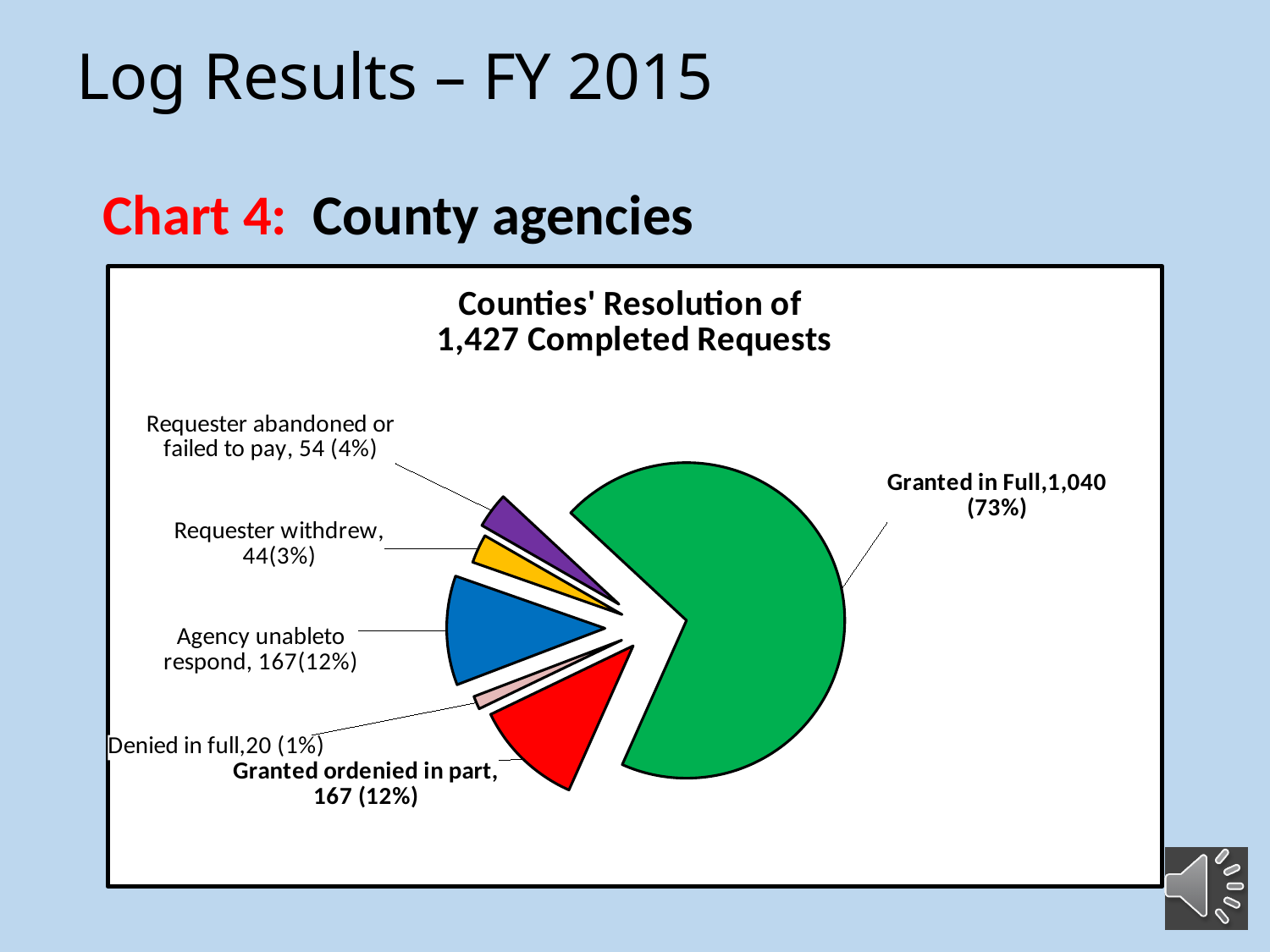
How many categories are shown in the pie chart? 6 What is the difference between the number of requests Granted in Full and the number where the Agency was unable to respond? 873 How many requests were Denied in full? 20 What is the title of the pie chart? Counties' Resolution of 1,427 Completed Requests What kind of chart is shown on the slide? pie chart How many requests fall under 'Requester abandoned or failed to pay'? 54 Which is larger: the number of requests where the Requester withdrew or the number where the Requester abandoned or failed to pay? Requester abandoned or failed to pay Which category has the largest slice of the pie? Granted in Full Which category has the smallest slice of the pie? Denied in full What percentage of completed requests were Granted in Full? 73% How many requests were Granted in Full? 1,040 What share of requests did the Requester withdraw? 3%